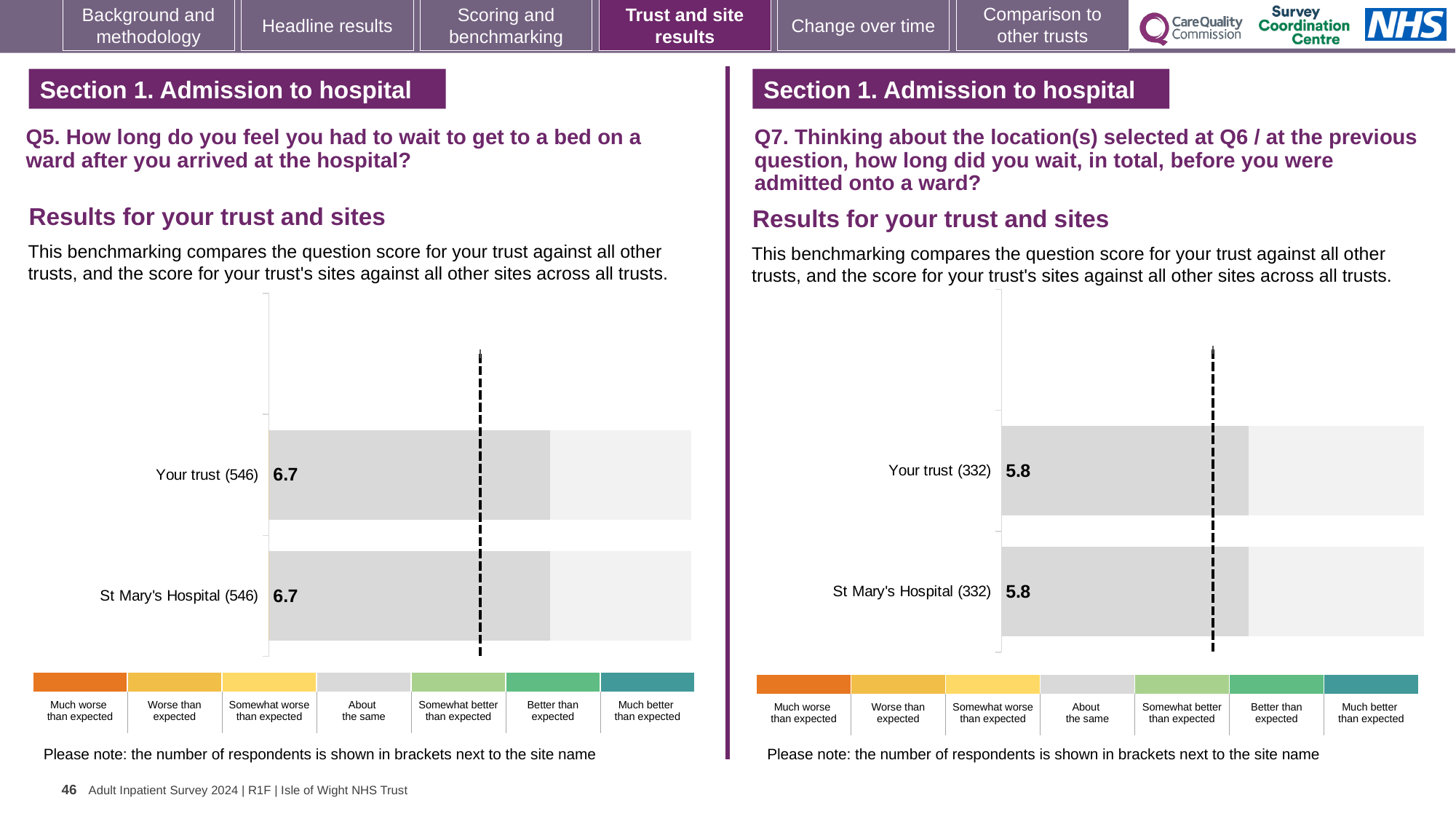
In the left chart (Q5), what is the difference between the score for Your trust and the score for St Mary's Hospital? 0 Is the score for Your trust in the right chart (Q7) greater or less than the score for Your trust in the left chart (Q5)? less In the left chart (Q5), how many respondents are shown in brackets next to Your trust? 546 In the right chart (Q7), how many respondents are shown in brackets next to St Mary's Hospital? 332 In the left chart (Q5), what is the score for Your trust? 6.7 How many bars are plotted in the right chart (Q7)? 2 In the right chart (Q7), what is the score for St Mary's Hospital? 5.8 How many bars are plotted in the left chart (Q5)? 2 What kind of chart is used for the Q5 results on the left? Bar chart In the left chart (Q5), what is the score for St Mary's Hospital? 6.7 In the right chart (Q7), what is the score for Your trust? 5.8 In the right chart (Q7), what is the difference between the score for Your trust and the score for St Mary's Hospital? 0